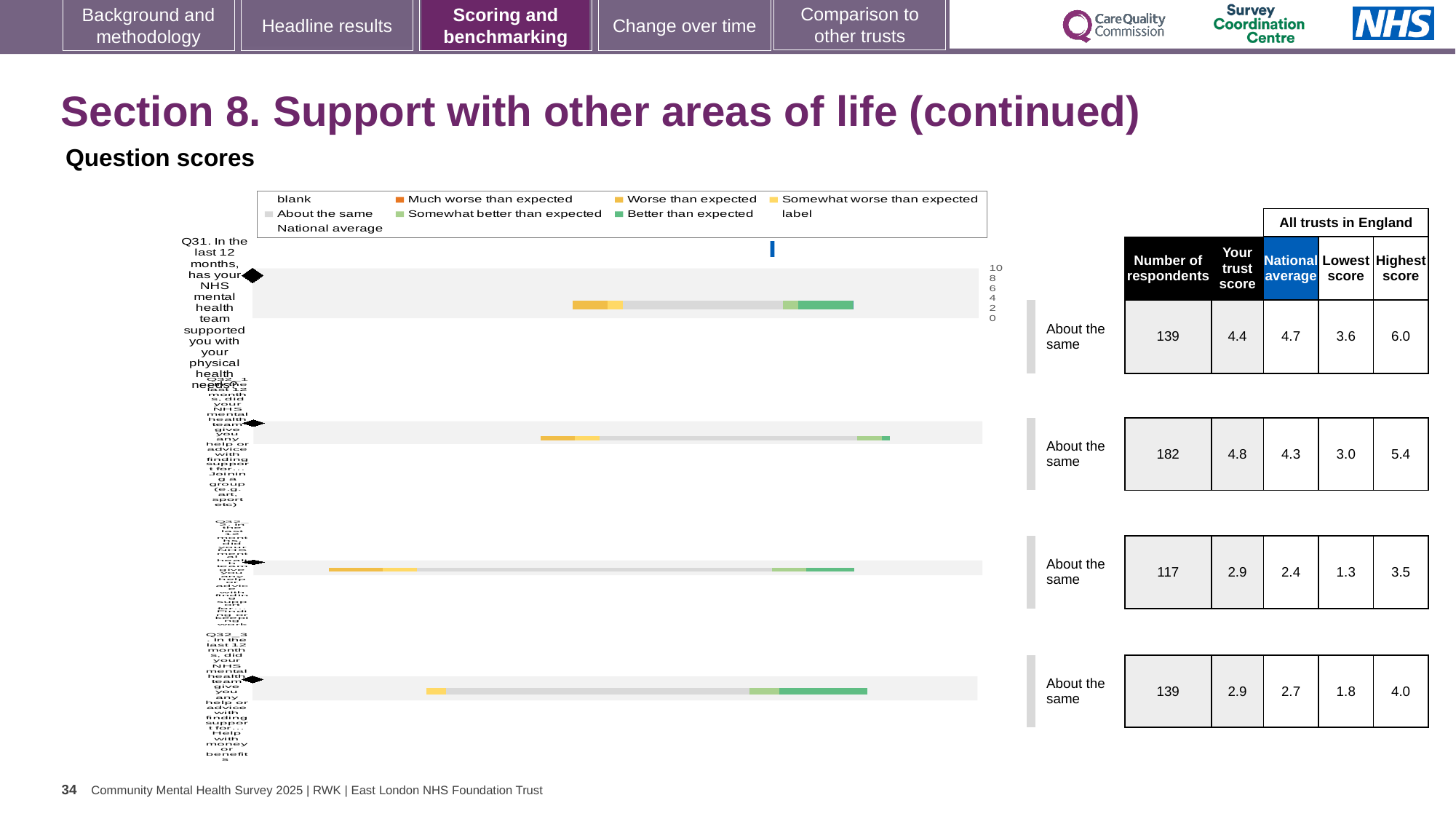
What benchmark category is shown next to the first chart (Q31)? About the same In the legend, which category is shown in grey? About the same How many question charts are shown on the slide? 4 For the first chart (Q31, support with physical health needs), how many respondents are listed in the table? 139 For the first chart (Q31), which is larger: the trust score or the national average? National average Which chart has the highest number of respondents? The second chart (182) For the fourth chart (help with money or benefits), what is the lowest score among all trusts in England? 1.8 For the second chart, what is the difference between the trust score (4.8) and the national average (4.3)? 0.5 For the first chart (Q31), what is the national average? 4.7 For the first chart (Q31), what is the trust's score? 4.4 What kind of chart is used to show the question scores on this slide? Bar chart For the third chart, what is the highest score among all trusts in England? 3.5